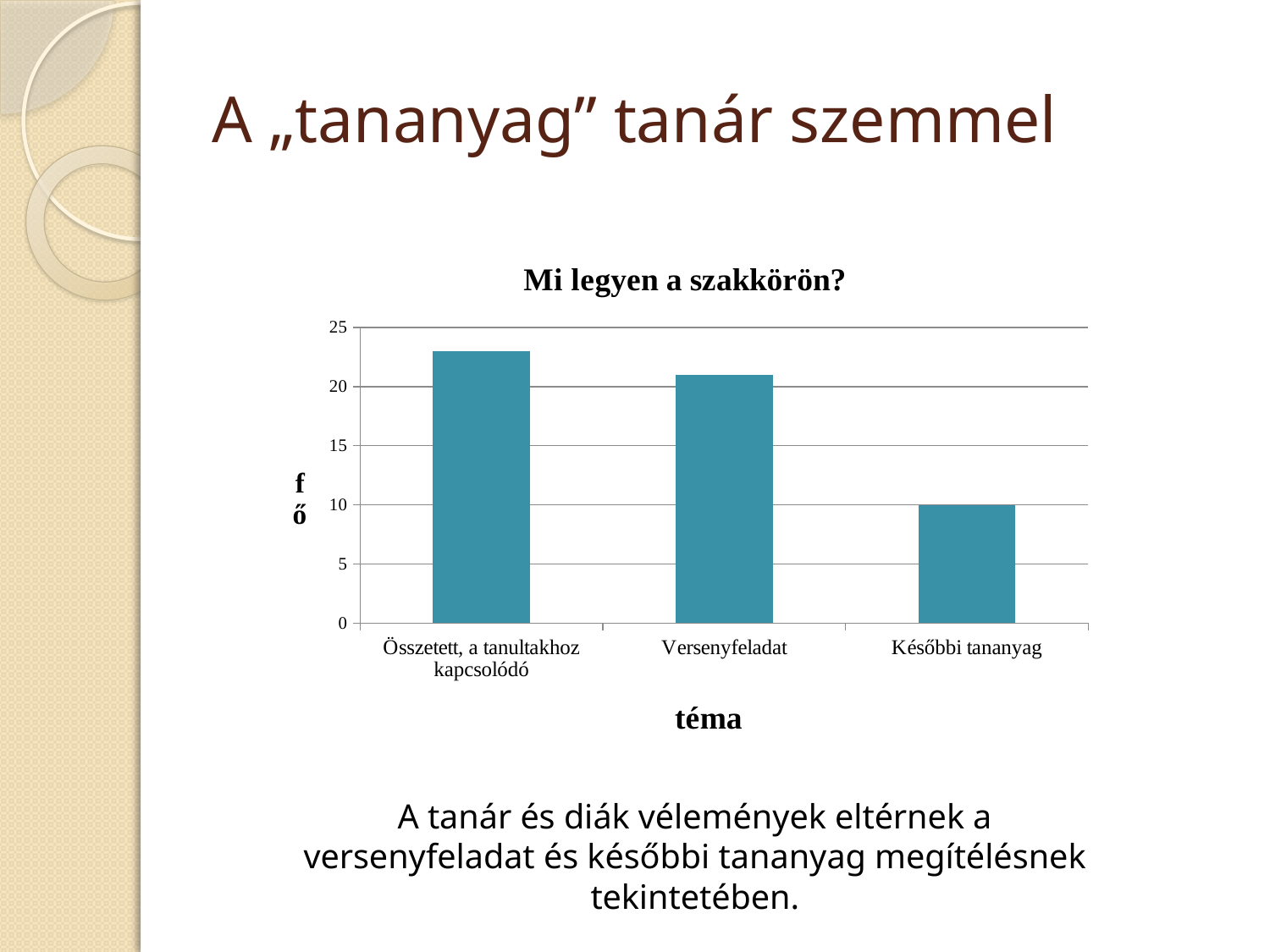
Is the value for Összetett, a tanultakhoz kapcsolódó greater or less than 20? greater Which is larger, the value for Versenyfeladat or the value for Későbbi tananyag? Versenyfeladat Is the value for Későbbi tananyag greater or less than 15? less Which category has the highest value in the chart? Összetett, a tanultakhoz kapcsolódó Which category has the lowest value in the chart? Későbbi tananyag What is the title of the chart? Mi legyen a szakkörön? How many categories are shown on the x axis of the chart? 3 What is the value for Későbbi tananyag? 10 Do the values rise or fall from left to right along the x axis? fall Is the value for Versenyfeladat greater or less than 25? less What is the label of the x axis of the chart? téma What kind of chart is shown on the slide? bar chart